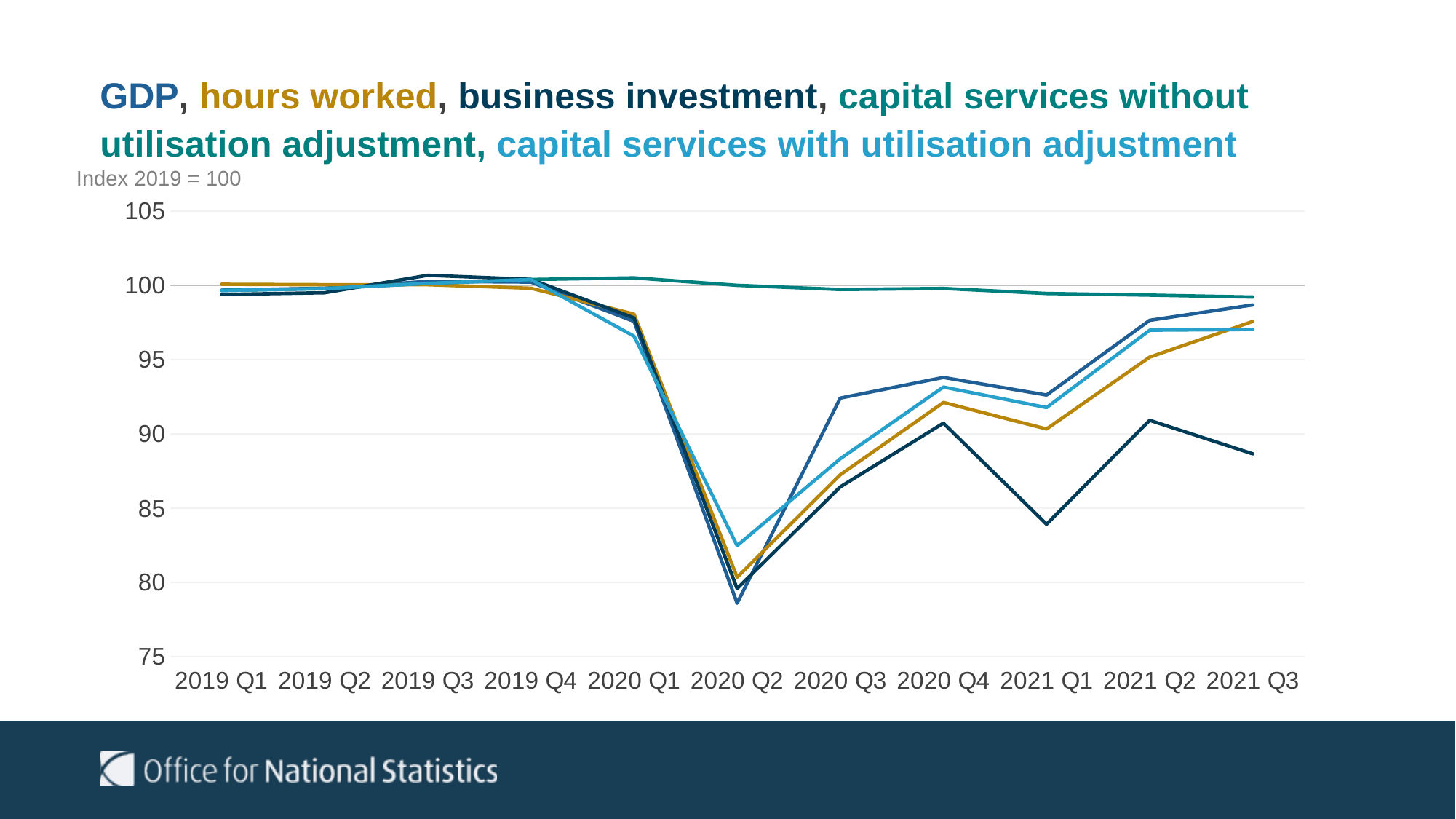
Does the business investment line rise or fall from 2021 Q2 to 2021 Q3? fall How many series does the chart plot? 5 Is the value for hours worked in 2020 Q2 greater or less than 85? less How many quarters are shown along the x axis? 11 Which series has the lowest value in 2021 Q3? business investment Is the value for capital services without utilisation adjustment in 2020 Q2 greater or less than 95? greater What is the index base stated below the chart title? Index 2019 = 100 Is the value for business investment in 2021 Q1 greater or less than 90? less Which series has the highest value in 2020 Q2? capital services without utilisation adjustment In 2021 Q3, which is larger: GDP or business investment? GDP What kind of chart is shown on the slide? line chart In which quarter does the GDP line reach its lowest point? 2020 Q2